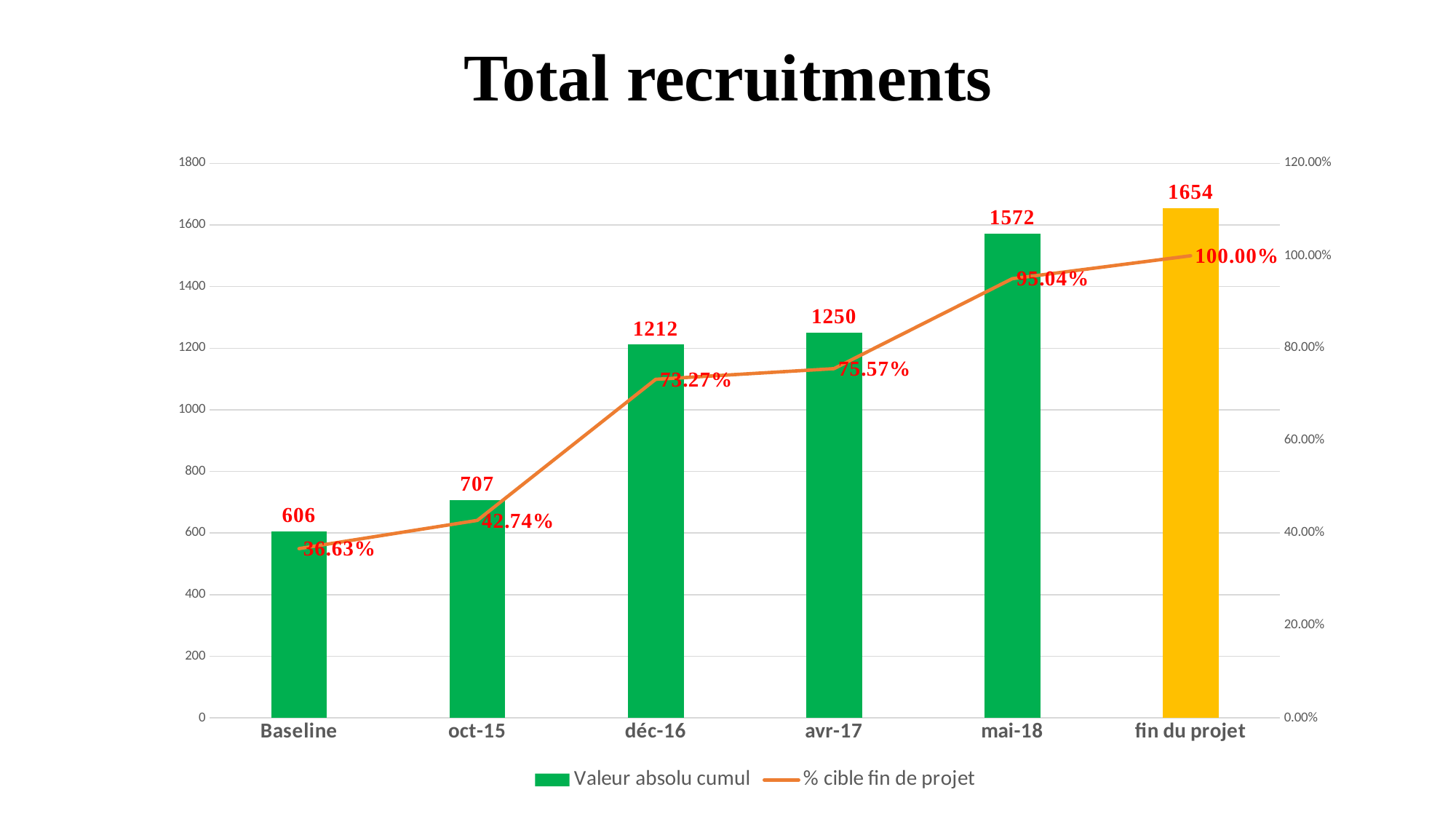
Which category has the lowest '% cible fin de projet' value? Baseline How many series does the legend list? 2 Which category has the highest 'Valeur absolu cumul' value? fin du projet Which is larger, the 'Valeur absolu cumul' for oct-15 or for déc-16? déc-16 What is the difference in 'Valeur absolu cumul' between mai-18 and avr-17? 322 What is the value of 'Valeur absolu cumul' for déc-16? 1212 What is the '% cible fin de projet' value for mai-18? 95.04% What is the 'Valeur absolu cumul' value at Baseline? 606 Do the '% cible fin de projet' values rise or fall from Baseline to fin du projet? rise What is the title of the chart? Total recruitments What kind of chart is this? Combined bar and line chart How many categories are shown on the x axis? 6